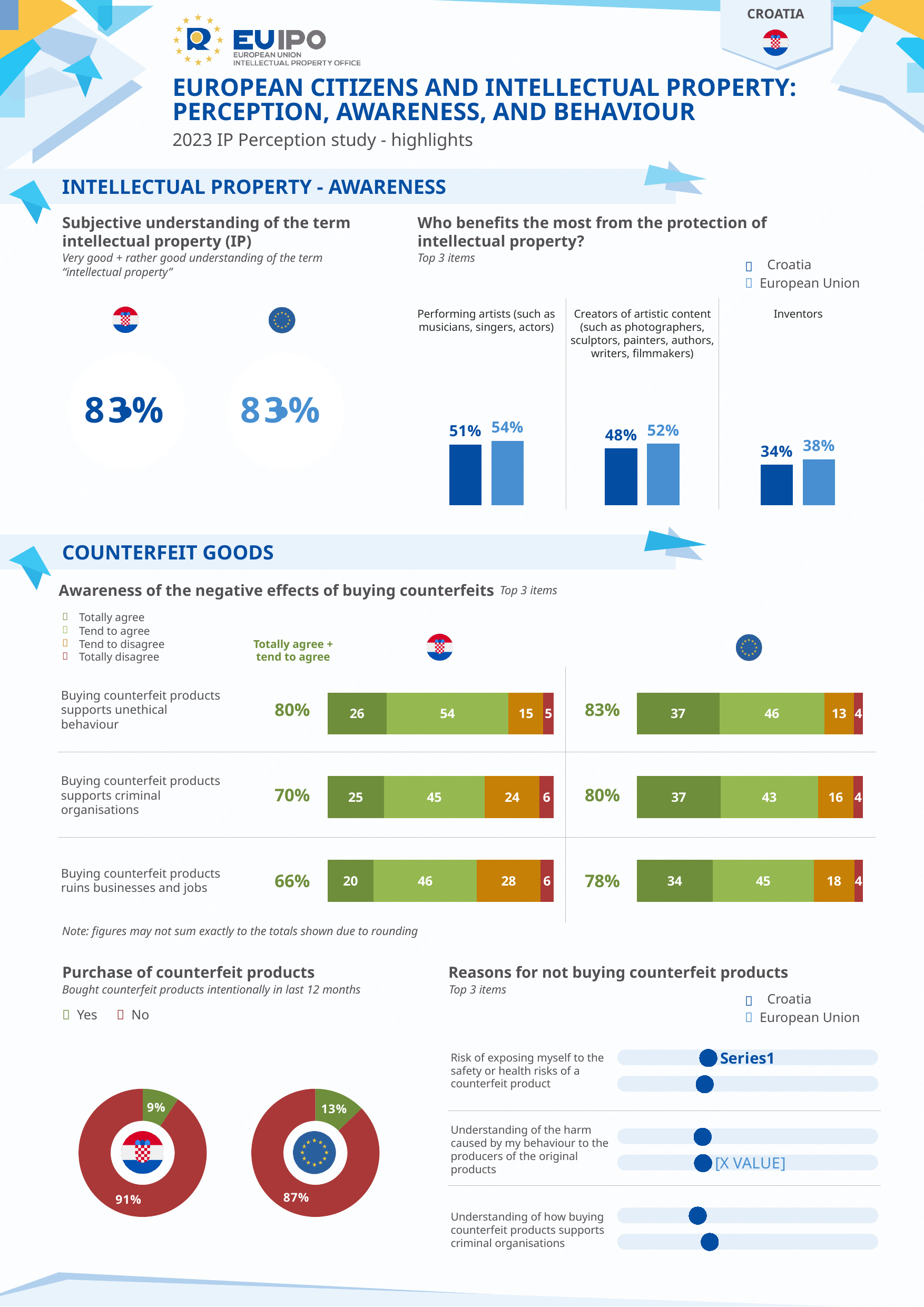
In the 'Who benefits the most from the protection of intellectual property?' chart, what is the difference between the European Union and Croatia values for Creators of artistic content? 4 percentage points In the 'Who benefits the most from the protection of intellectual property?' chart, what is the European Union value for Inventors? 38% In the 'Who benefits the most from the protection of intellectual property?' chart, how many series does the legend list? 2 In the 'Awareness of the negative effects of buying counterfeits' chart, what is the 'Tend to agree' value for the European Union on 'Buying counterfeit products ruins businesses and jobs'? 45 In the 'Who benefits the most from the protection of intellectual property?' chart, what is the Croatia value for Performing artists? 51% In the 'Purchase of counterfeit products' donut charts, what is the difference between the European Union and Croatia 'Yes' shares? 4 percentage points In the 'Awareness of the negative effects of buying counterfeits' chart, which statement has the highest European Union 'Totally agree + tend to agree' value? Buying counterfeit products supports unethical behaviour In the 'Purchase of counterfeit products' donut charts, what share of Croatia respondents answered Yes? 9% What kind of chart is used for 'Who benefits the most from the protection of intellectual property?' Bar chart In the 'Awareness of the negative effects of buying counterfeits' chart, is the Croatia 'Tend to disagree' value for 'Buying counterfeit products ruins businesses and jobs' larger or smaller than the European Union value for the same statement? Larger In the 'Awareness of the negative effects of buying counterfeits' chart, what is the Croatia 'Totally agree + tend to agree' value for 'Buying counterfeit products supports criminal organisations'? 70% In the 'Who benefits the most from the protection of intellectual property?' chart, which item has the lowest Croatia value? Inventors